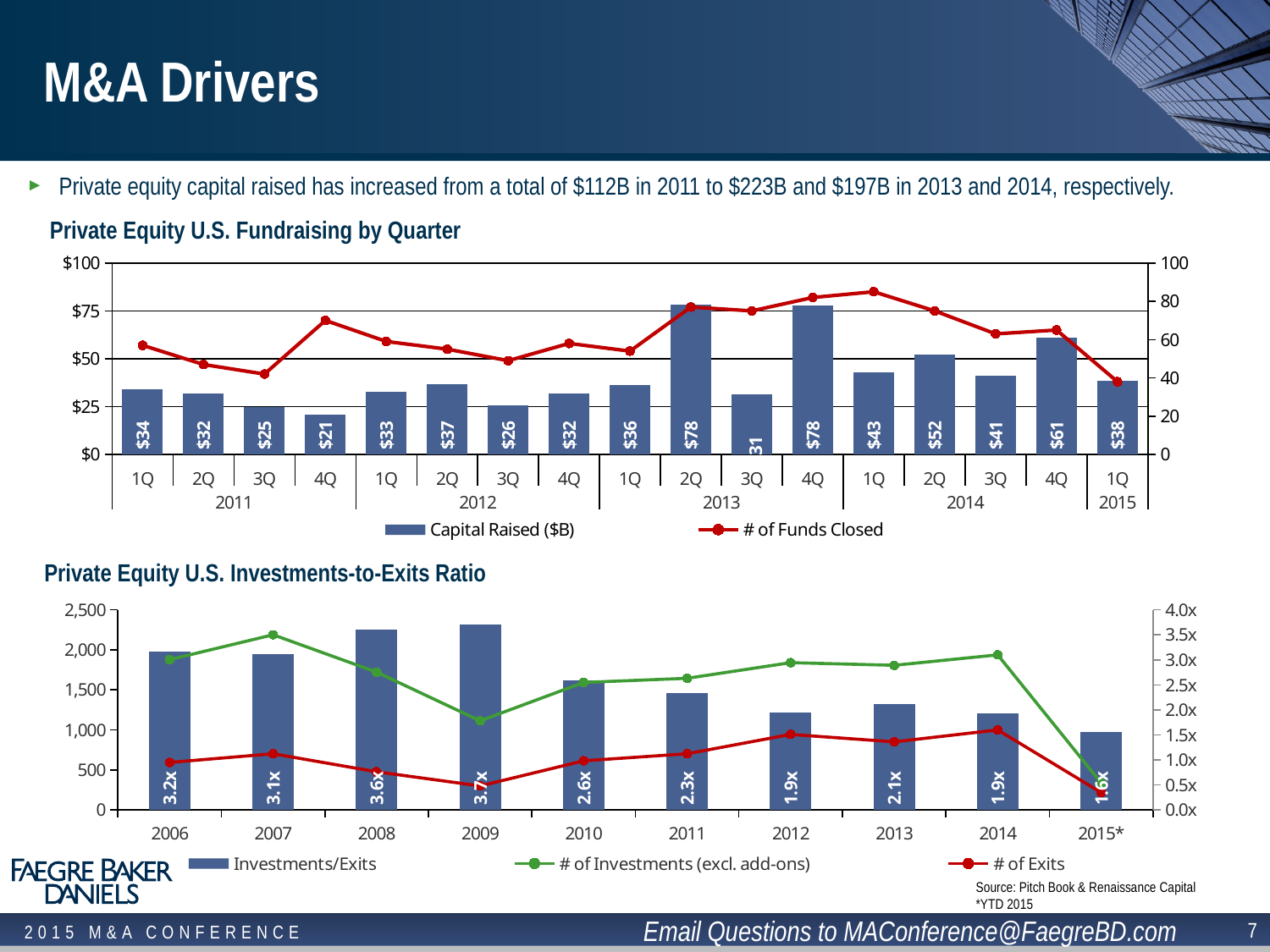
In the Private Equity U.S. Fundraising by Quarter chart, what is the difference in capital raised between 4Q 2014 and 1Q 2015? $23 In the Private Equity U.S. Fundraising by Quarter chart, how many quarters are plotted? 17 In the Private Equity U.S. Investments-to-Exits Ratio chart, does the # of Investments line rise or fall from 2014 to 2015*? fall In the Private Equity U.S. Investments-to-Exits Ratio chart, which year has the highest ratio? 2009 In the Private Equity U.S. Fundraising by Quarter chart, is the number of funds closed in 1Q 2014 greater or less than 80? greater In the Private Equity U.S. Fundraising by Quarter chart, what is the highest capital raised value shown? $78 In the Private Equity U.S. Fundraising by Quarter chart, how much capital was raised in 2Q 2013? $78 In the Private Equity U.S. Investments-to-Exits Ratio chart, which year has the lowest ratio? 2015* In the Private Equity U.S. Fundraising by Quarter chart, how many series does the legend list? 2 In the Private Equity U.S. Investments-to-Exits Ratio chart, which year has the larger ratio, 2012 or 2013? 2013 In the Private Equity U.S. Investments-to-Exits Ratio chart, what is the ratio for 2009? 3.7x In the Private Equity U.S. Fundraising by Quarter chart, which quarter has the lowest capital raised? 4Q 2011